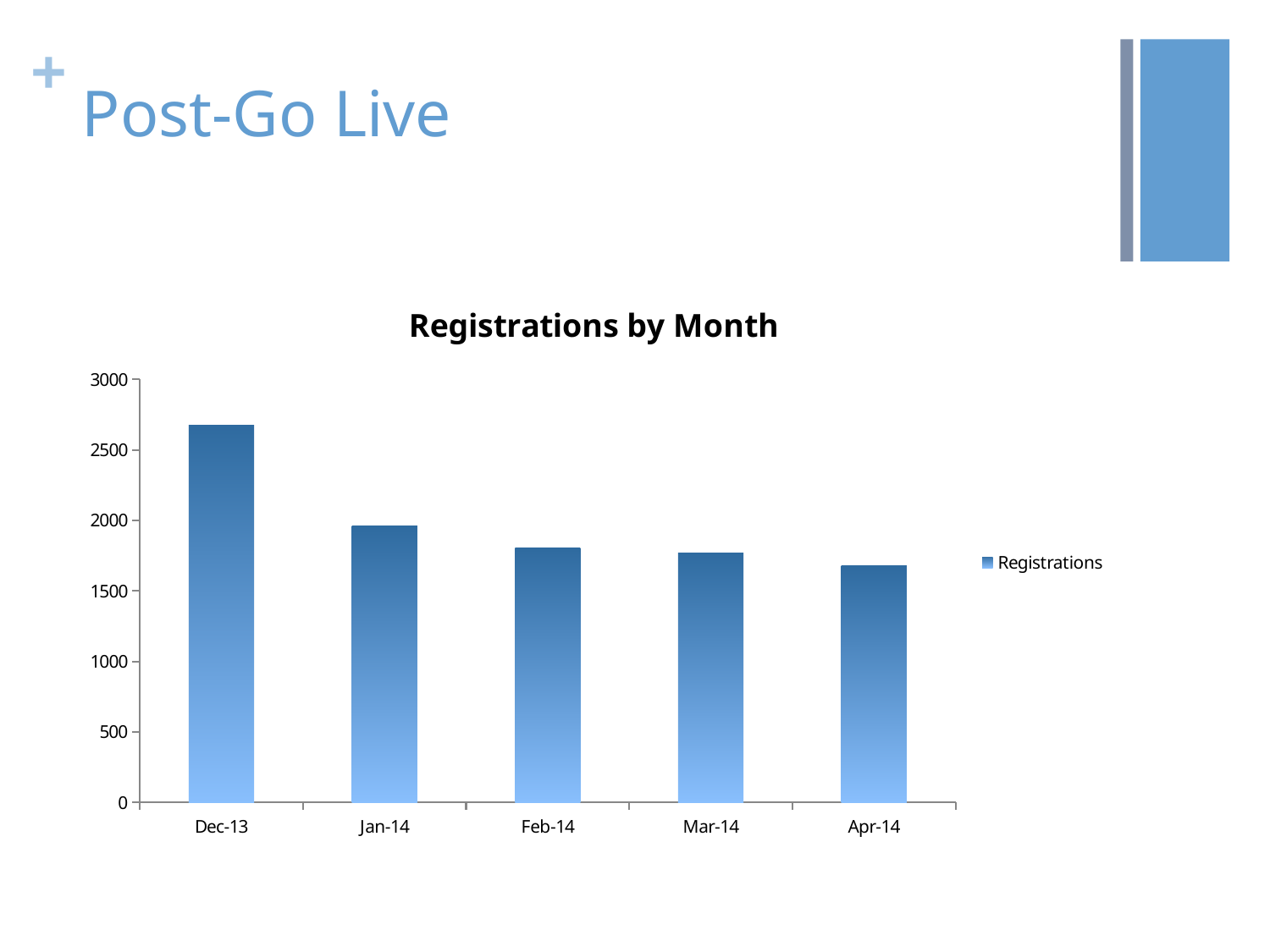
How many series does the chart legend list? 1 What is the name of the series shown in the legend? Registrations Which is larger, the value for Dec-13 or the value for Jan-14? Dec-13 Is the value for Apr-14 greater or less than 1500? greater Which month has the highest number of registrations? Dec-13 Do registrations rise or fall from Dec-13 to Apr-14? fall How many months are shown on the x axis of the chart? 5 Which month has the lowest number of registrations? Apr-14 Is the value for Dec-13 greater or less than 2500? greater What type of chart is shown on the slide? bar chart What is the title of the chart? Registrations by Month Is the value for Jan-14 greater or less than 2000? less